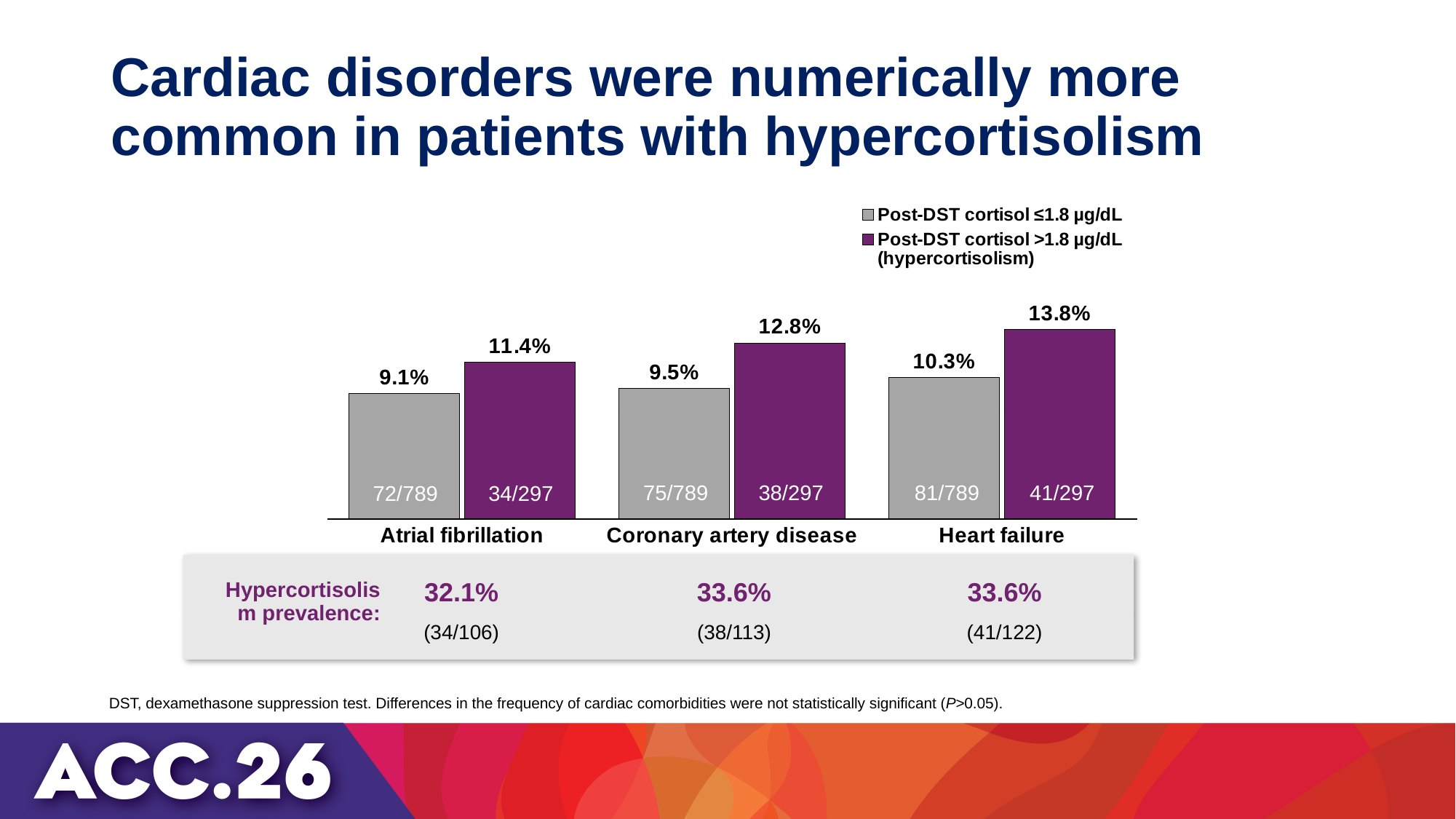
What is the value for Coronary artery disease in the Post-DST cortisol >1.8 µg/dL (hypercortisolism) series? 12.8% What is the value for Atrial fibrillation in the Post-DST cortisol ≤1.8 µg/dL series? 9.1% What kind of chart is shown on the slide? Bar chart Which category has the highest value in the Post-DST cortisol ≤1.8 µg/dL series? Heart failure Which category has the lowest value in the Post-DST cortisol >1.8 µg/dL (hypercortisolism) series? Atrial fibrillation Do the values in the Post-DST cortisol ≤1.8 µg/dL series rise or fall from Atrial fibrillation to Heart failure? Rise How many categories are shown on the x axis? 3 What is the difference between the hypercortisolism and ≤1.8 µg/dL values for Coronary artery disease? 3.3% Which is larger for Atrial fibrillation: the Post-DST cortisol ≤1.8 µg/dL value or the hypercortisolism value? Hypercortisolism (11.4%) What is the value for Heart failure in the Post-DST cortisol >1.8 µg/dL (hypercortisolism) series? 13.8% What is the difference between the hypercortisolism and ≤1.8 µg/dL values for Heart failure? 3.5% How many series does the legend list? 2